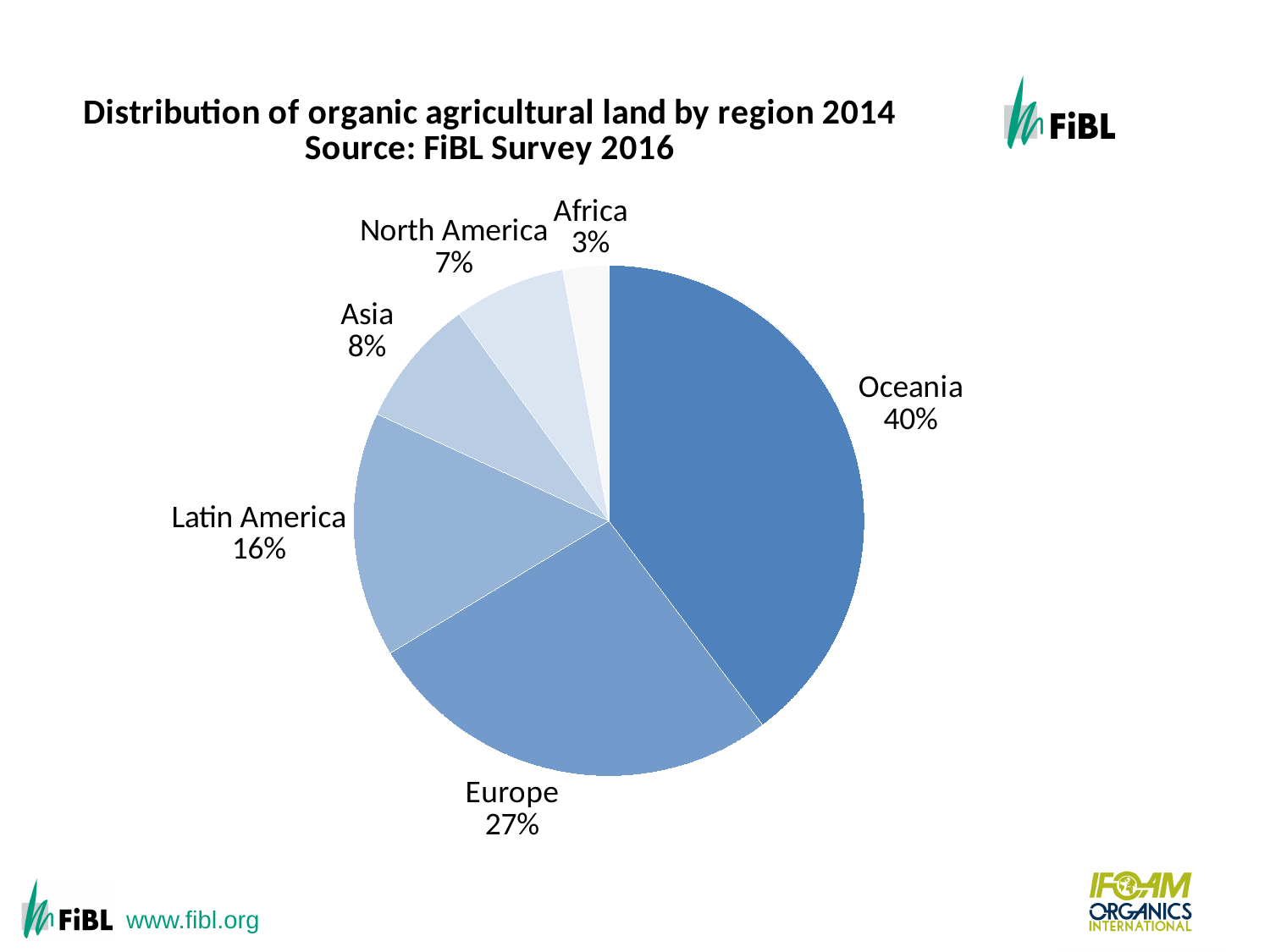
What type of chart is shown on the slide? pie chart Which region has the smallest share of organic agricultural land? Africa What percentage is shown for Africa? 3% What is the value shown for Europe? 27% What share of organic agricultural land does Oceania hold? 40% Which region has the largest share of organic agricultural land? Oceania What percentage is shown for Latin America? 16% How many regions are shown in the pie chart? 6 What is the difference in percentage points between Oceania and Europe? 13 What is the value shown for Asia? 8% What is the title of the chart? Distribution of organic agricultural land by region 2014 Which has a larger share, Latin America or North America? Latin America